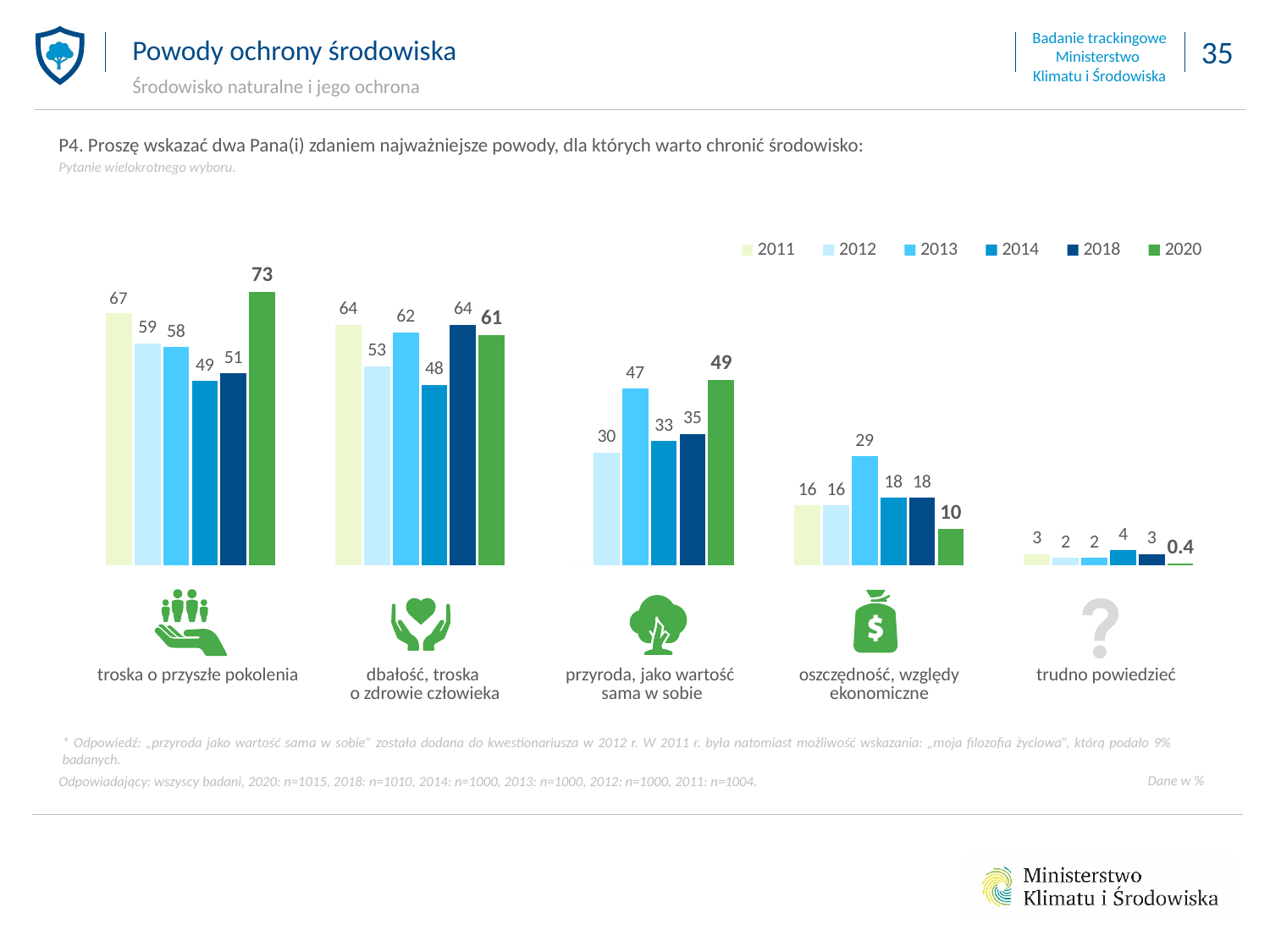
What is the value for 2020 in the category "troska o przyszłe pokolenia"? 73 How many series does the legend list? 6 What is the difference between the 2020 and 2011 values in the category "troska o przyszłe pokolenia"? 6 What is the value for 2013 in the category "oszczędność, względy ekonomiczne"? 29 Which category has the lowest value for 2011? trudno powiedzieć What is the value for 2020 in the category "trudno powiedzieć"? 0.4 What is the value for 2014 in the category "dbałość, troska o zdrowie człowieka"? 48 Which category has the highest value for 2020? troska o przyszłe pokolenia How many categories are shown on the x axis? 5 What kind of chart is shown on the slide? bar chart Which is larger in the category "oszczędność, względy ekonomiczne": the value for 2013 or the value for 2020? 2013 What is the difference between the 2013 and 2012 values in the category "przyroda, jako wartość sama w sobie"? 17